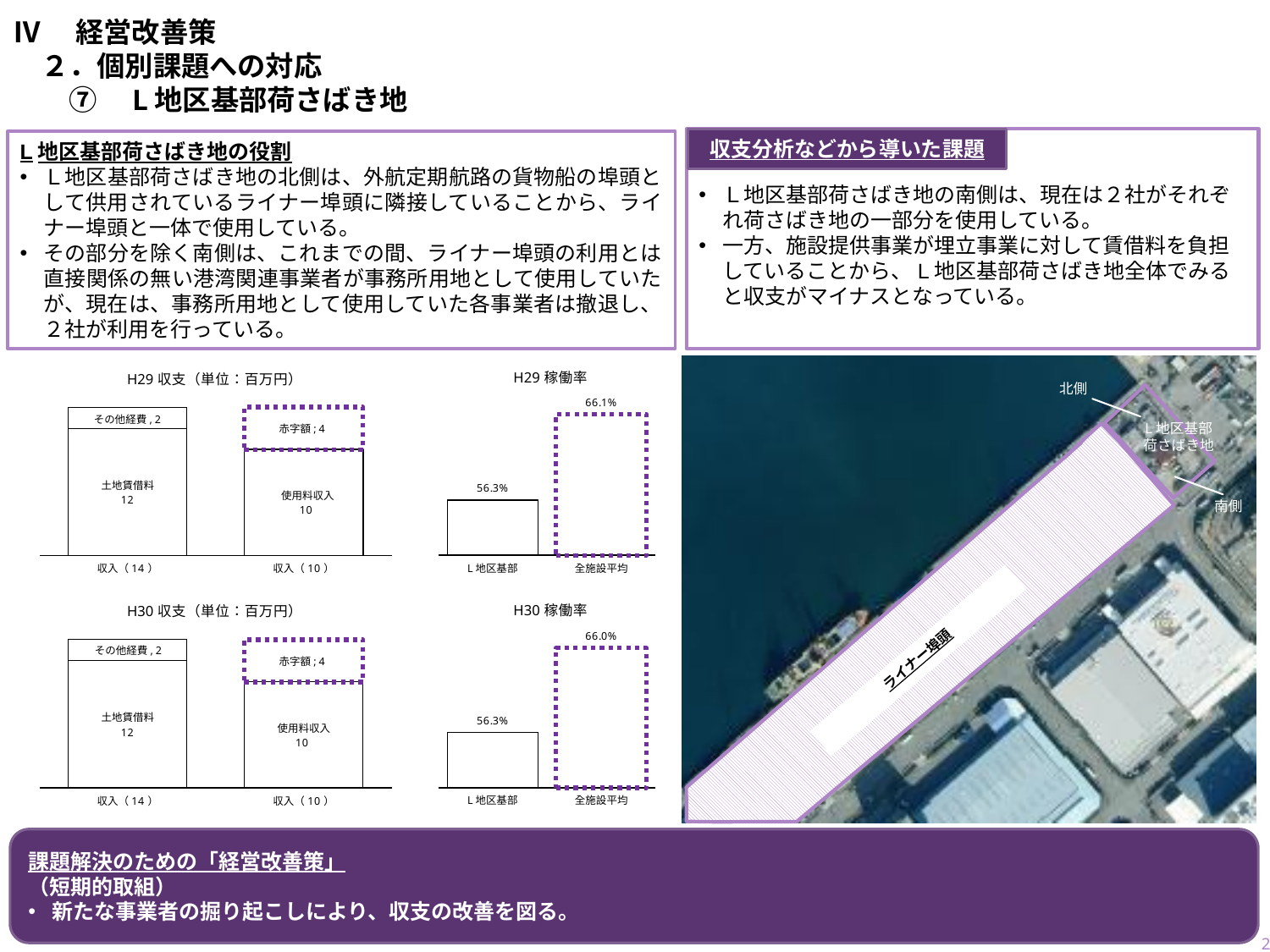
In the H29 稼働率 chart, which category has the higher value, L地区基部 or 全施設平均? 全施設平均 How many categories are shown in the H30 稼働率 chart? 2 In the H30 収支 chart, what is the value of 使用料収入? 10 In the H29 稼働率 chart, what is the value for 全施設平均? 66.1% In the H30 稼働率 chart, what is the difference between 全施設平均 and L地区基部? 9.7 percentage points In the H29 収支 chart, what is the value of 土地賃借料? 12 In the H29 収支 chart, what is the value of 赤字額? 4 What kind of chart is the H30 稼働率 chart? Bar chart In the H29 稼働率 chart, what is the difference between 全施設平均 and L地区基部? 9.8 percentage points In the H30 収支 chart, what is the total of the left stacked bar (その他経費 plus 土地賃借料)? 14 In the H29 稼働率 chart, what is the value for L地区基部? 56.3% In the H30 稼働率 chart, what is the value for 全施設平均? 66.0%